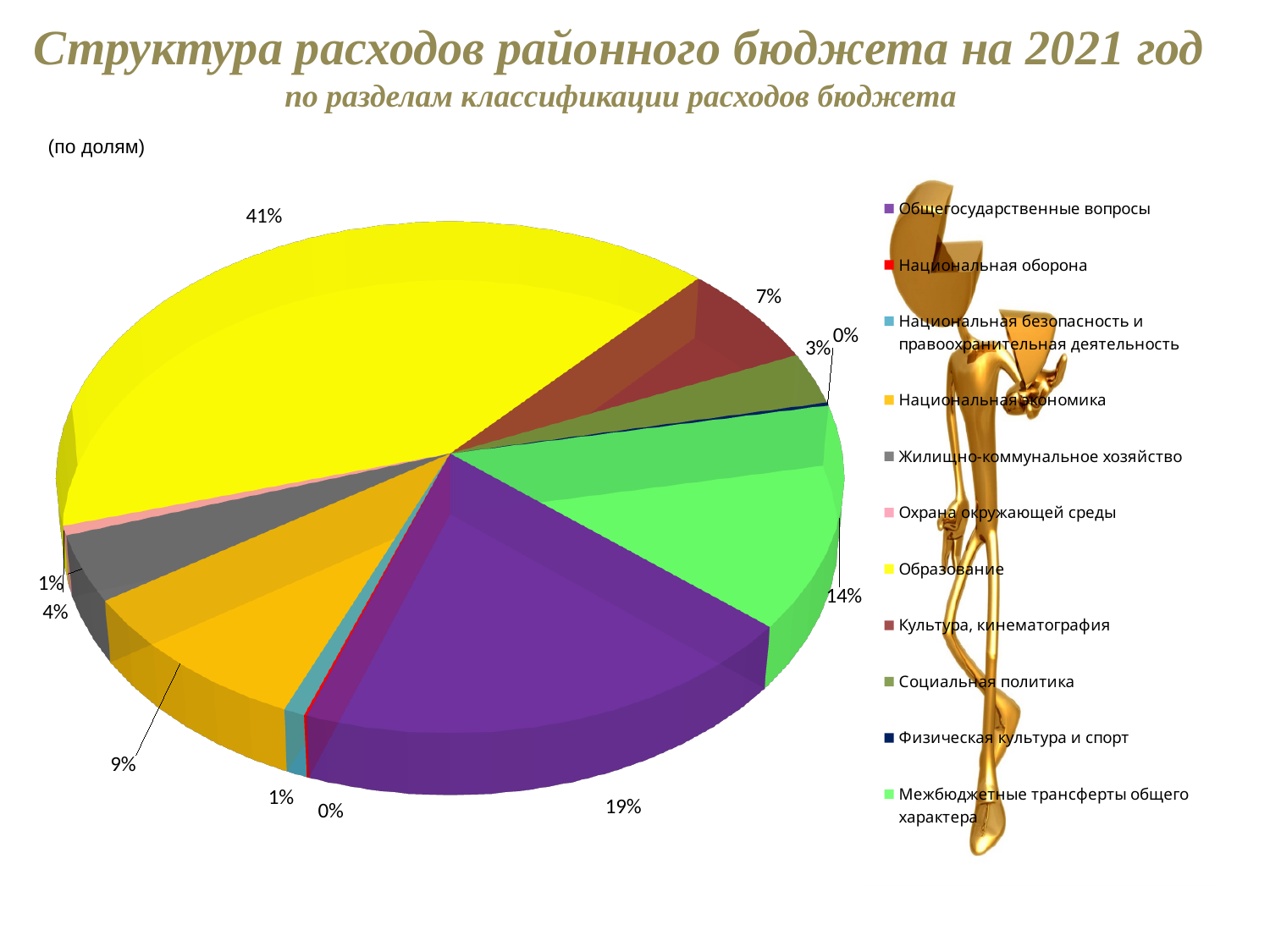
What colour is the slice for Образование? yellow What share is shown for Жилищно-коммунальное хозяйство? 4% What share is shown for Межбюджетные трансферты общего характера? 14% What kind of chart is shown on the slide? pie chart What share of the budget expenditure goes to Образование? 41% What is the difference between the share for Образование and the share for Общегосударственные вопросы? 22% How many categories does the legend list? 11 Which is larger, the share for Общегосударственные вопросы or the share for Межбюджетные трансферты общего характера? Общегосударственные вопросы What share is shown for Культура, кинематография? 7% What share is shown for Общегосударственные вопросы? 19% Which category has the largest share of the pie? Образование What share is shown for Национальная экономика? 9%